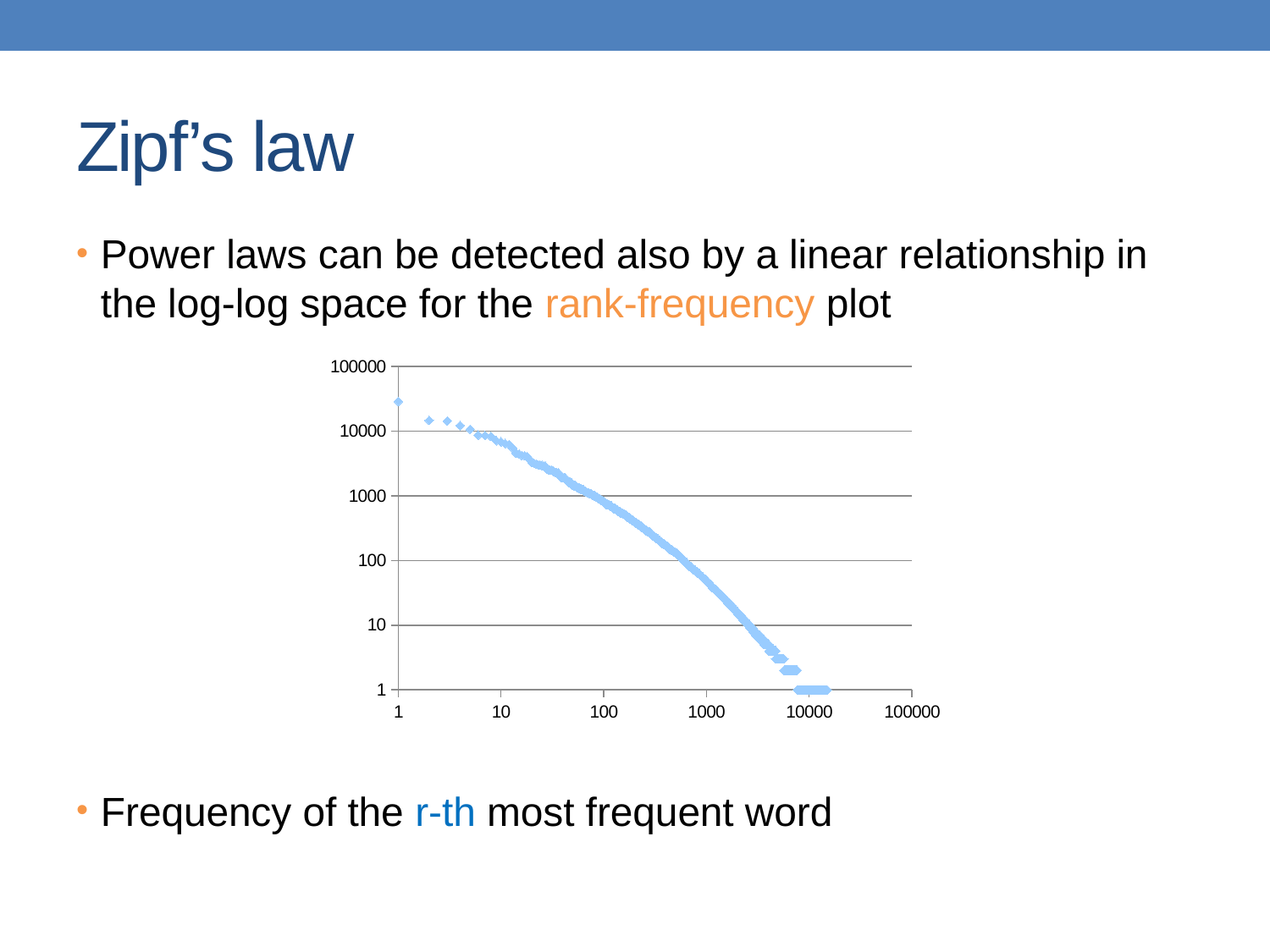
How many tick labels are shown on the x axis? 6 Is the frequency plotted at rank 10000 greater or less than 10? less What is the lowest frequency value reached by the plotted points? 1 How many data series are plotted in the chart? 1 What kind of chart is shown on the slide? scatter chart Do the plotted frequency values rise or fall as rank increases along the x axis? fall Is the frequency plotted at rank 1 greater or less than 10000? greater Is the frequency plotted at rank 1 greater or less than 100000? less At which rank is the highest frequency plotted? 1 What is the highest value labelled on the x axis? 100000 What is the highest value labelled on the y axis? 100000